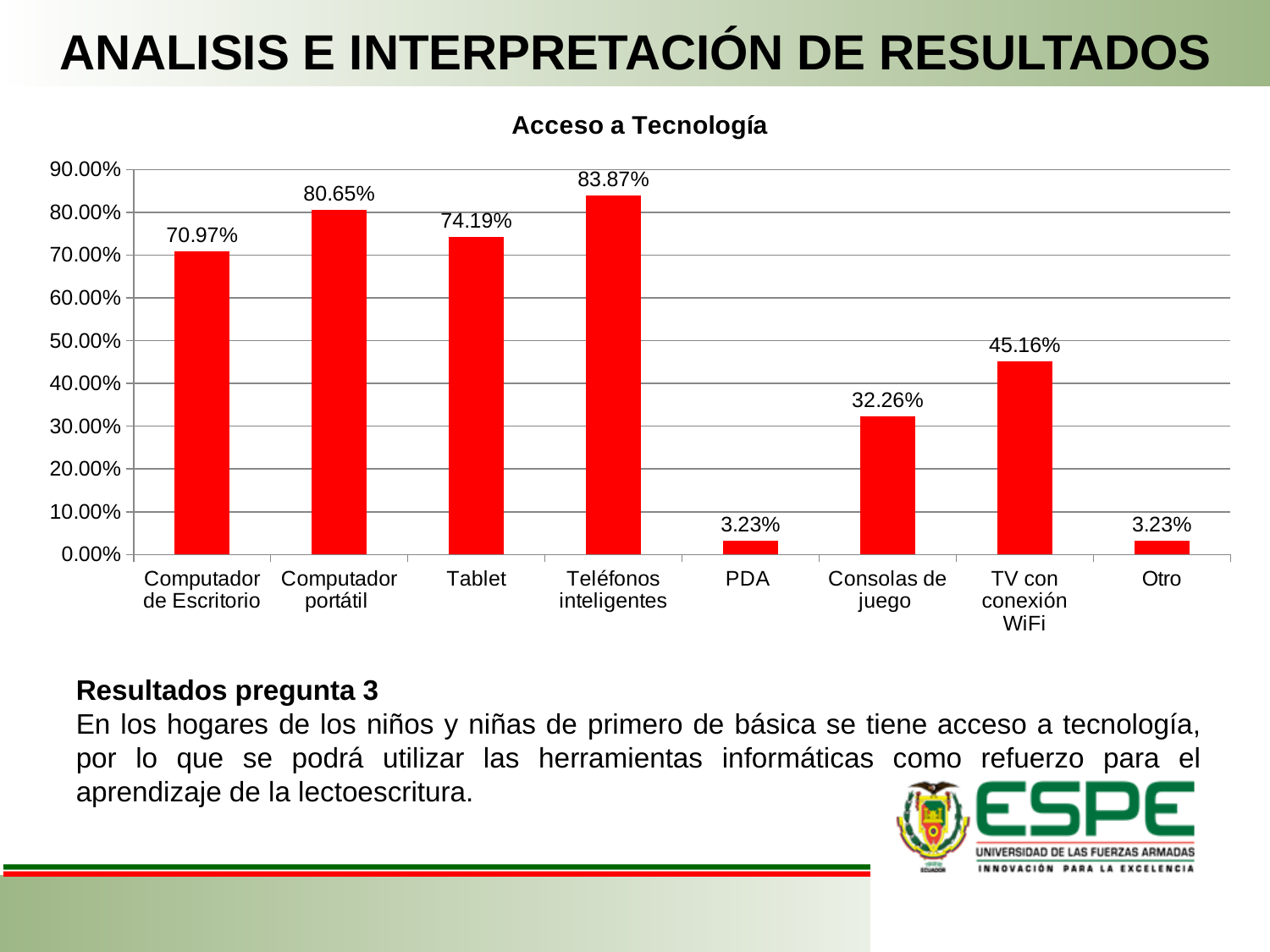
Which is larger, Tablet or Computador portátil? Computador portátil What is the value for TV con conexión WiFi? 45.16% What is the title of the chart? Acceso a Tecnología What colour are the bars in the chart? red Which category has the highest value in the chart? Teléfonos inteligentes How many categories are shown on the x axis of the chart? 8 What is the difference between Computador portátil and Computador de Escritorio? 9.68% Is the value for TV con conexión WiFi greater or less than 50.00%? less What kind of chart is shown on the slide? bar chart What is the difference between Teléfonos inteligentes and Consolas de juego? 51.61% What is the value for Tablet in the Acceso a Tecnología chart? 74.19% What is the value for Consolas de juego? 32.26%